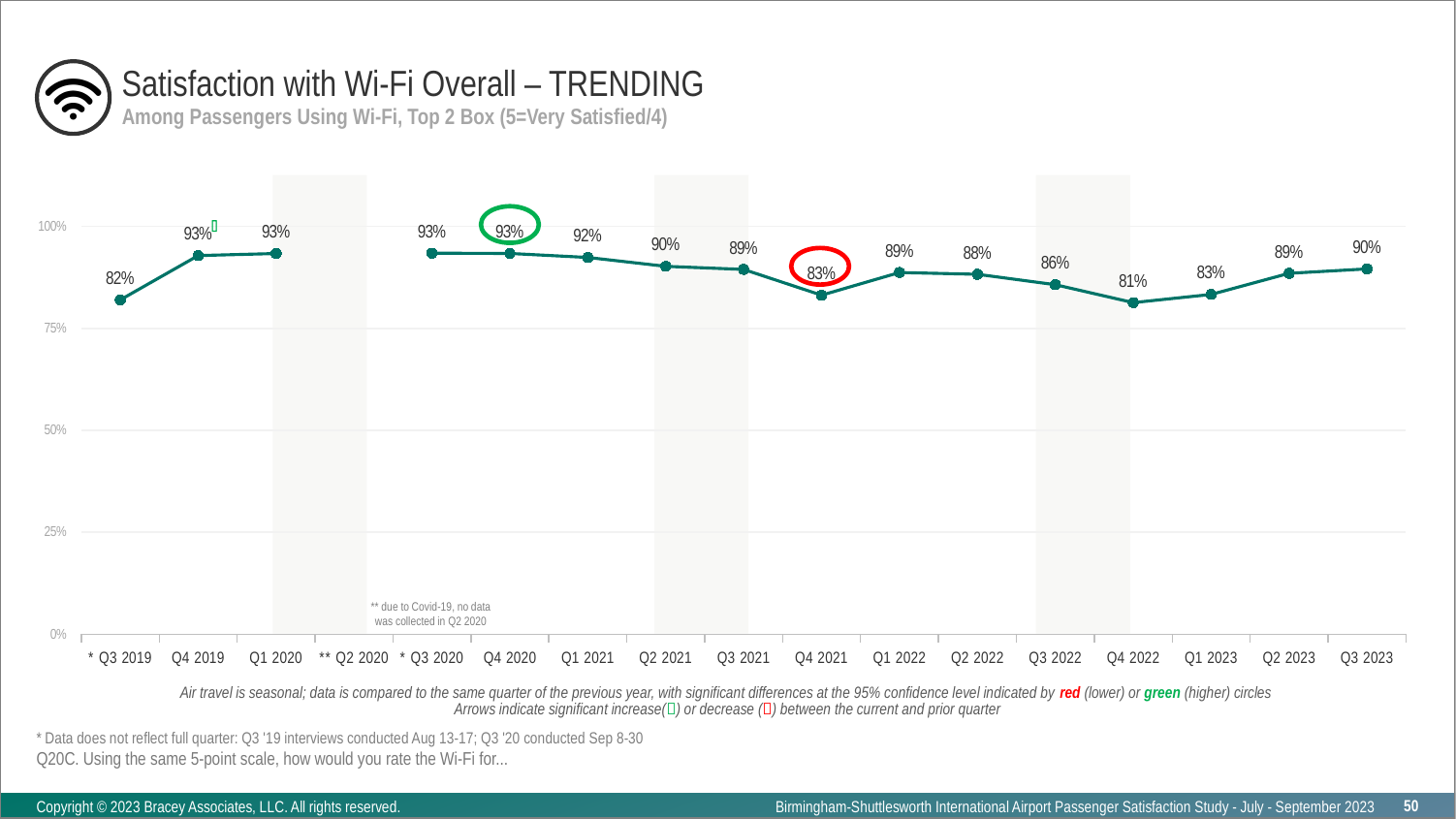
What is the Wi-Fi satisfaction value for Q3 2023? 90% What is the value shown for Q3 2022? 86% What is the value shown for Q3 2019? 82% What is the value shown for Q4 2021? 83% Is the value for Q4 2022 greater or less than 75%? greater Which quarter's data label is circled in green? Q4 2020 Which quarter on the x axis has no data plotted? Q2 2020 What is the difference between the values for Q2 2023 and Q1 2023? 6% Which is larger, the value for Q1 2021 or the value for Q4 2022? Q1 2021 Which quarter has the lowest satisfaction value? Q4 2022 What type of chart is shown on the slide? Line chart What is the difference between the values for Q3 2019 and Q4 2019? 11%